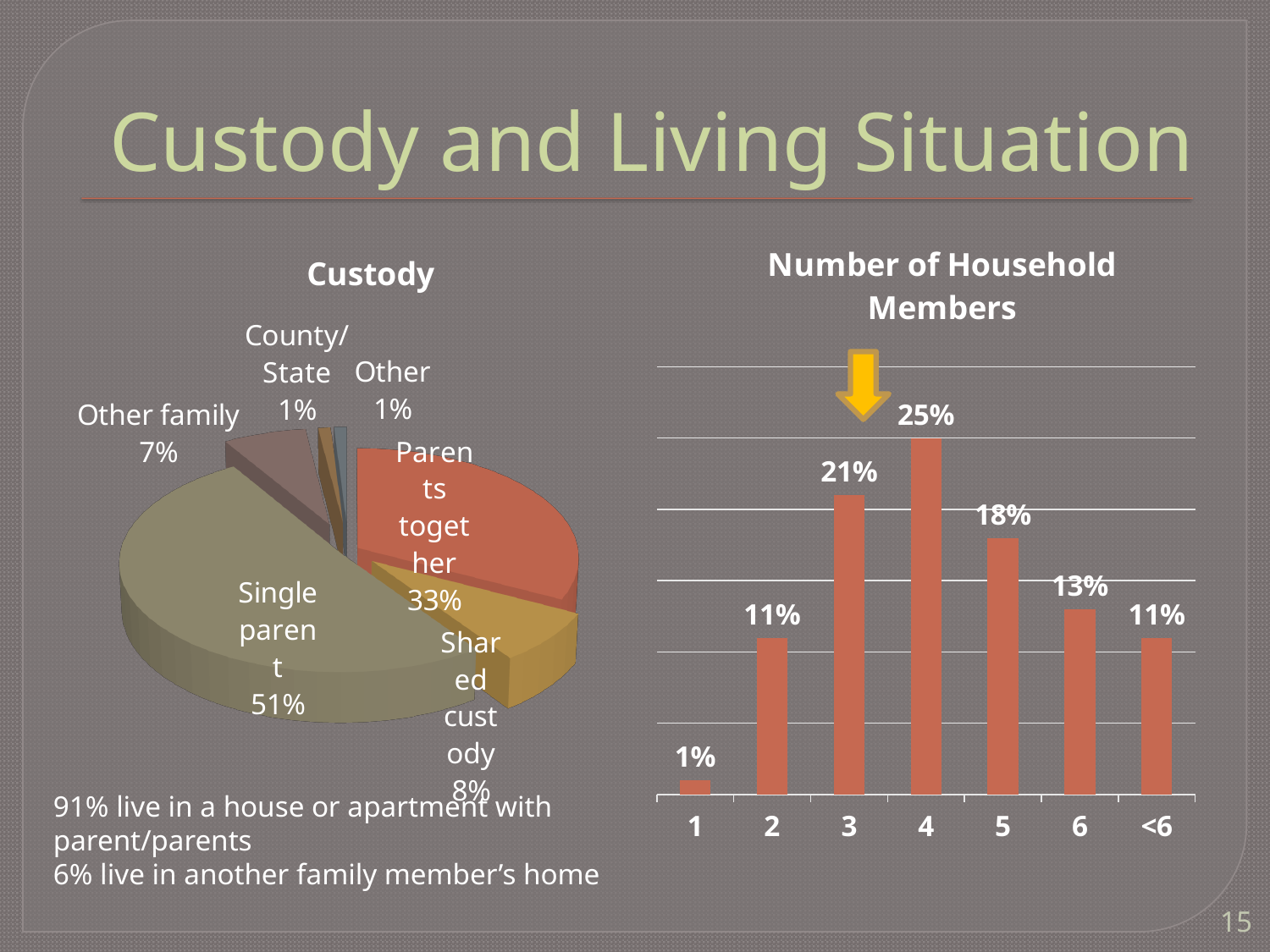
In the Number of Household Members chart, what is the value for 4 members? 25% In the Custody chart, what share is Parents together? 33% How many categories are shown on the x axis of the Number of Household Members chart? 7 In the Number of Household Members chart, which category has the lowest value? 1 How many categories does the Custody pie chart show? 6 In the Custody chart, what share is Single parent? 51% What kind of chart is the Number of Household Members chart? Bar chart In the Custody chart, which category has the largest share? Single parent In the Custody chart, which is larger: Other family or Shared custody? Shared custody What kind of chart is the Custody chart? Pie chart In the Number of Household Members chart, what is the difference between the values for 3 and 5 members? 3% In the Custody chart, what is the difference between the Single parent and Parents together shares? 18%